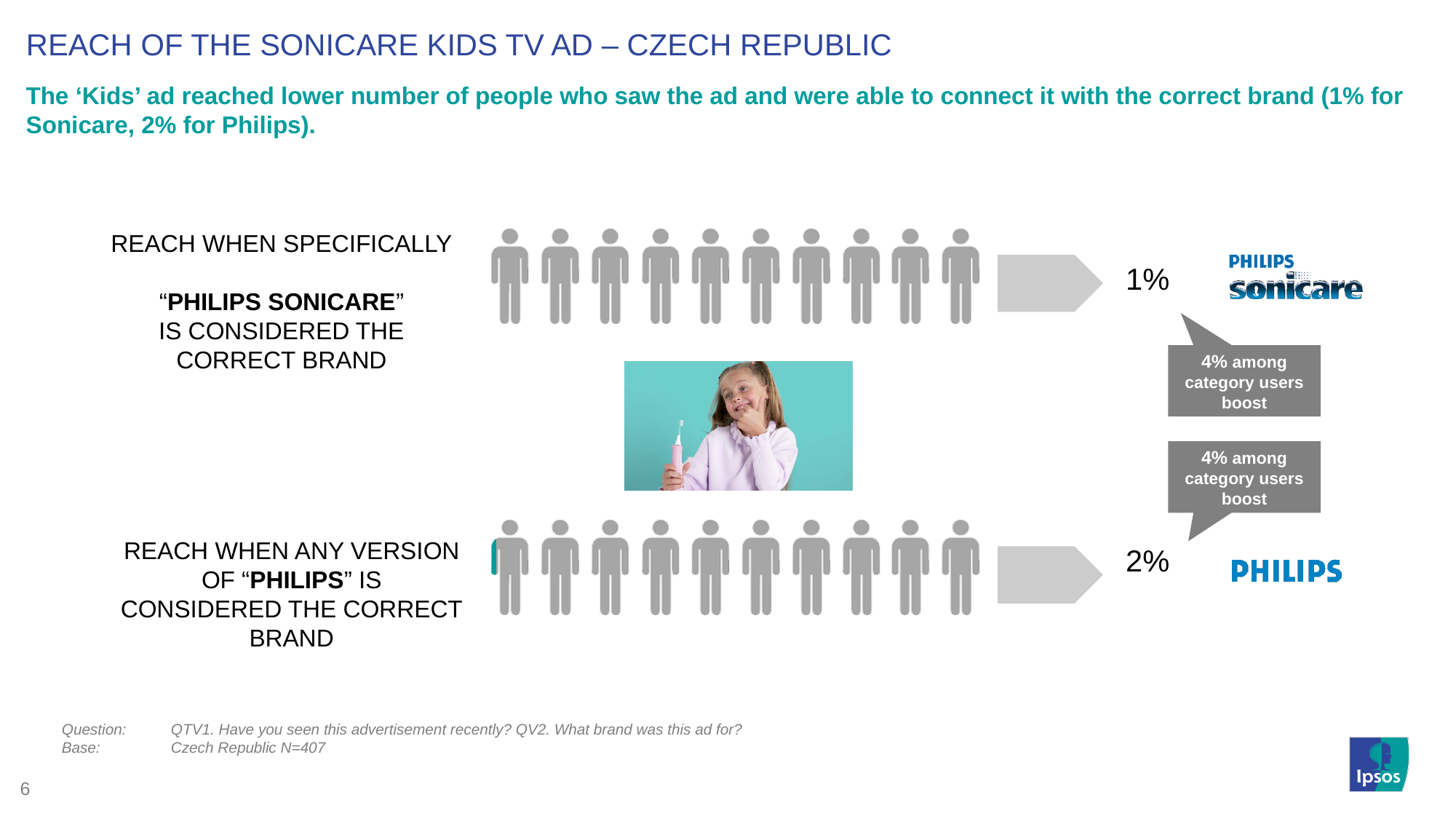
How many person icons are shown in the top row for "Philips Sonicare"? 10 Which reach figure is higher: when "Philips Sonicare" is the correct brand or when any version of "Philips" is the correct brand? Any version of "Philips" What is the reach among category users (boost) for any version of "Philips"? 4% What is the reach when specifically "Philips Sonicare" is considered the correct brand? 1% What is the reach among category users (boost) for "Philips Sonicare"? 4% Which country does the slide title say the Sonicare Kids TV ad reach refers to? Czech Republic Is the reach for any version of "Philips" greater or less than 5%? less What is the base size (N) for the Czech Republic shown on the slide? N=407 What is the difference between the reach for any version of "Philips" and the reach for "Philips Sonicare"? 1% How many person icons are shown in the bottom row for any version of "Philips"? 10 What kind of chart is used to show the reach figures on this slide? Pictograph (icon chart) What is the reach when any version of "Philips" is considered the correct brand? 2%